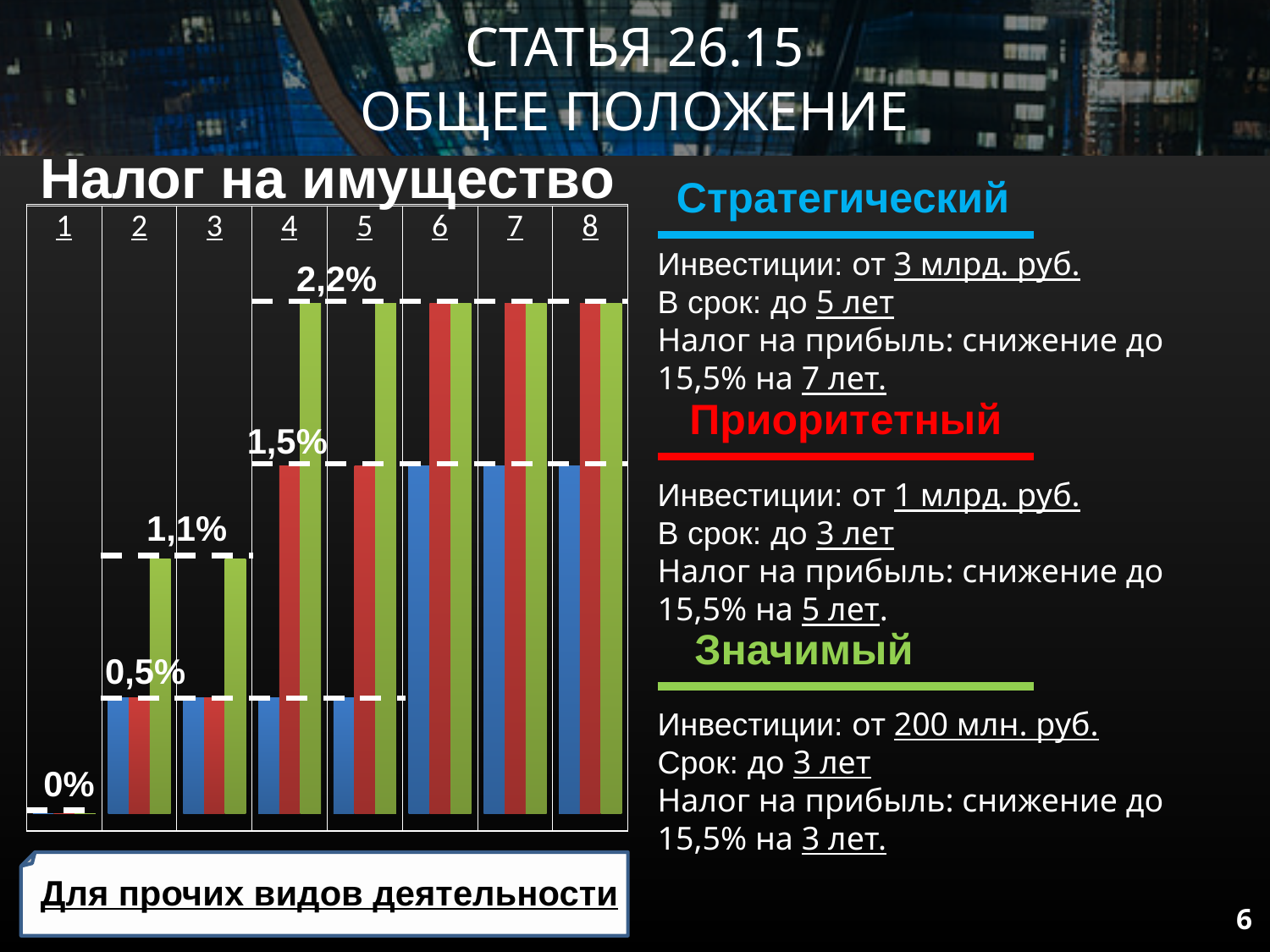
What is the value of the green bar in category 4? 2,2% What is the difference between the green bar and the blue bar in category 4? 1,7% What is the value of the red bar in category 4? 1,5% In category 2, which is larger: the green bar or the blue bar? green bar What is the value shown for category 1? 0% How many categories (numbered periods) are shown along the x axis of the chart? 8 What is the value of the blue bar in category 6? 1,5% What is the title of the chart? Налог на имущество How many series (bar colours) are plotted for each category in the chart? 3 Which bar colour has the highest value in category 4? green What is the value of the green bar in category 2? 1,1% What kind of chart is shown under the title "Налог на имущество"? bar chart